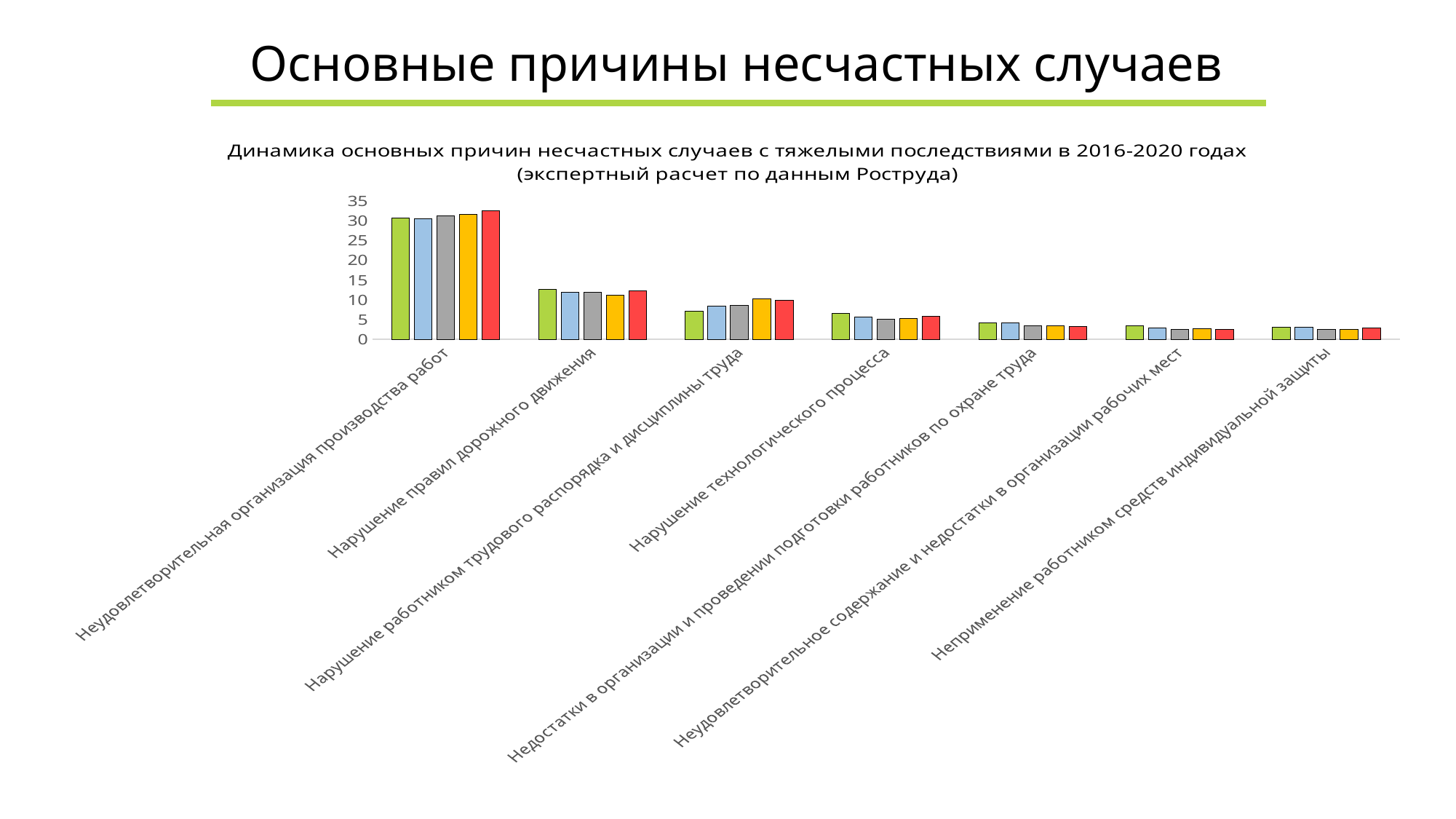
What is the title of the chart? Динамика основных причин несчастных случаев с тяжелыми последствиями в 2016-2020 годах (экспертный расчет по данным Роструда) What kind of chart is shown on the slide? bar chart Which category has the highest values in the chart? Неудовлетворительная организация производства работ Are the values for 'Нарушение правил дорожного движения' greater or less than 15? less Which category has larger values: 'Неудовлетворительная организация производства работ' or 'Нарушение правил дорожного движения'? Неудовлетворительная организация производства работ Are the values for 'Нарушение технологического процесса' greater or less than 10? less Are the values for 'Неприменение работником средств индивидуальной защиты' greater or less than 5? less How many categories (causes) are shown on the x axis of the chart? 7 Do the values generally rise or fall moving from left to right across the categories? fall Which category has larger values: 'Нарушение правил дорожного движения' or 'Недостатки в организации и проведении подготовки работников по охране труда'? Нарушение правил дорожного движения How many bars are plotted for each category in the chart? 5